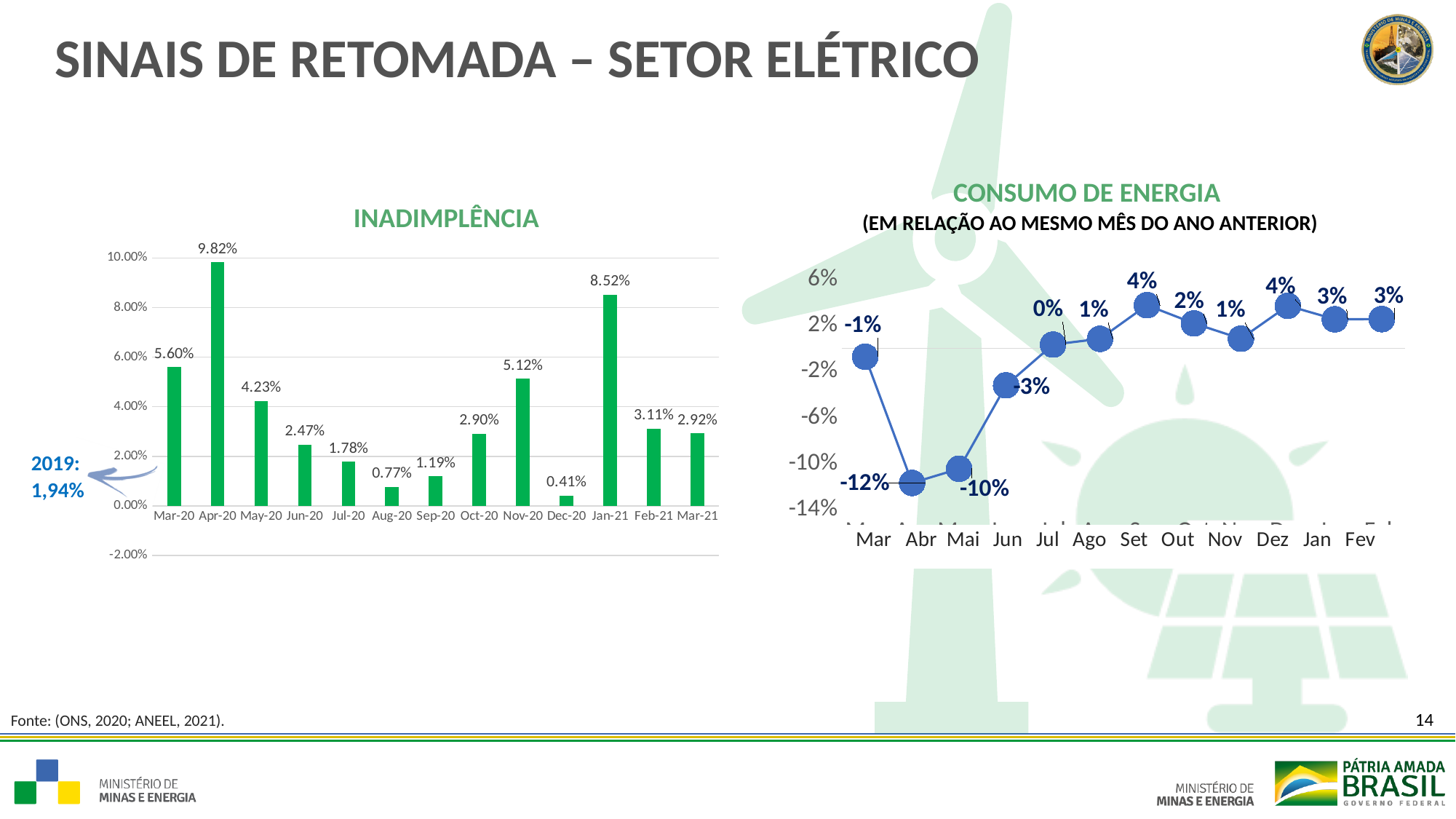
In the INADIMPLÊNCIA chart, which month has the highest value? Apr-20 How many months are shown in the INADIMPLÊNCIA chart? 13 What kind of chart is the CONSUMO DE ENERGIA chart? Line chart In the INADIMPLÊNCIA chart, what is the value for Apr-20? 9.82% In the INADIMPLÊNCIA chart, what is the difference between the values for Jan-21 and Feb-21? 5.41% In the CONSUMO DE ENERGIA chart, do the values rise or fall from Abr to Set? Rise In the CONSUMO DE ENERGIA chart, what is the difference between the values for Set and Jun? 7% In the CONSUMO DE ENERGIA chart, which month has the lowest value? Abr What kind of chart is the INADIMPLÊNCIA chart? Bar chart In the INADIMPLÊNCIA chart, which is larger, the value for Nov-20 or the value for Mar-20? Mar-20 In the INADIMPLÊNCIA chart, which month has the lowest value? Dec-20 In the CONSUMO DE ENERGIA chart, what is the value for Abr? -12%